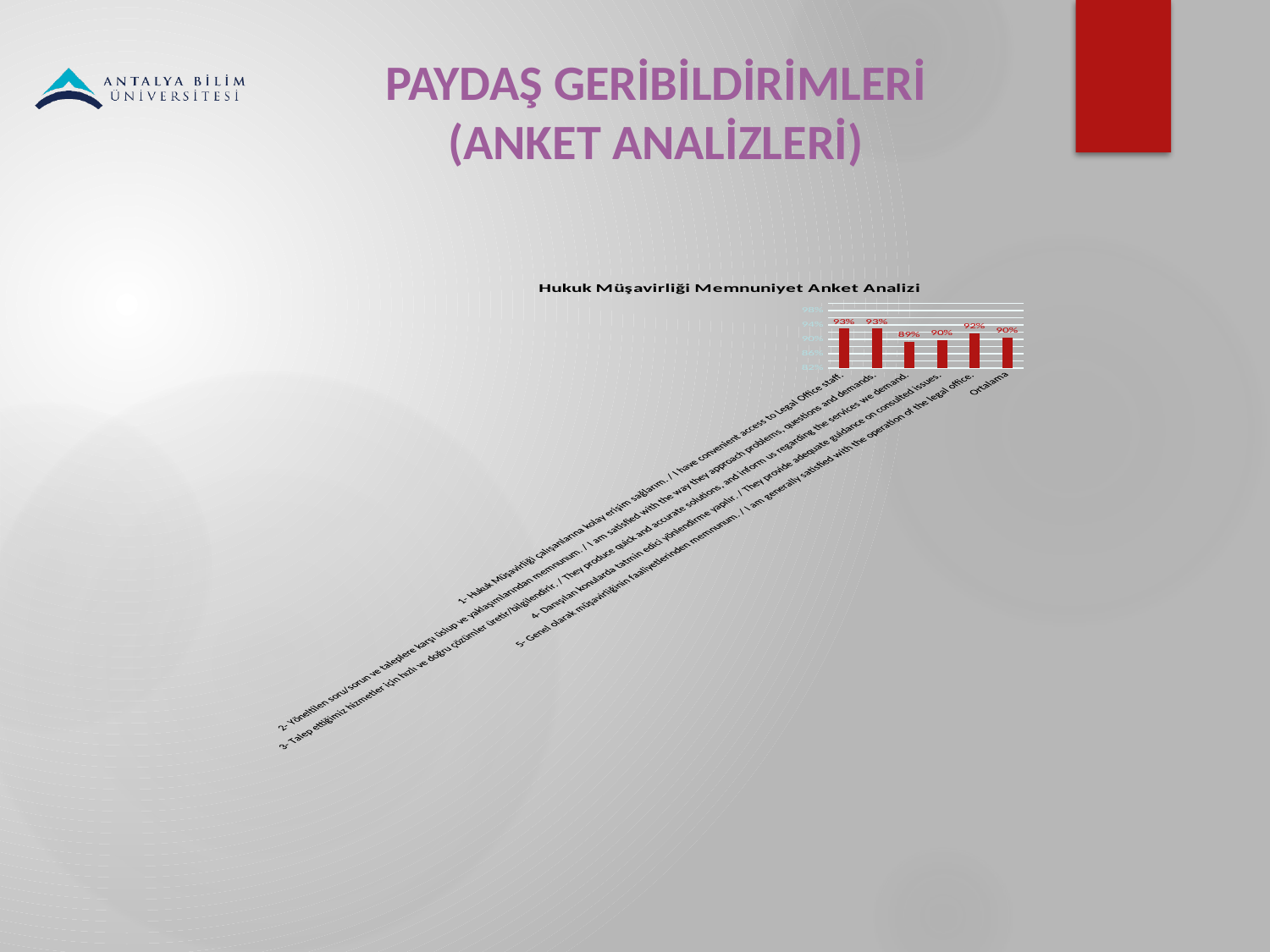
Which category has the lowest value in the Hukuk Müşavirliği Memnuniyet Anket Analizi chart? 3- Talep ettiğimiz hizmetler için hızlı ve doğru çözümler üretir/bilgilendirir. What kind of chart is shown on the slide? Bar chart Which has the larger value in the chart: item 4 or item 5? Item 5 What is the title of the chart on the slide? Hukuk Müşavirliği Memnuniyet Anket Analizi What is the value shown for item 3 ("3- Talep ettiğimiz hizmetler için hızlı ve doğru çözümler üretir/bilgilendirir.") in the chart? 89% What colour are the bars in the chart? Red What is the value shown for item 1 ("1- Hukuk Müşavirliği çalışanlarına kolay erişim sağlarım.") in the chart? 93% What is the difference between the value for item 1 and the value for "Ortalama" in the chart? 3% How many bars are shown in the Hukuk Müşavirliği Memnuniyet Anket Analizi chart? 6 What is the difference between the values for item 2 and item 3 in the chart? 4% What is the value shown for "Ortalama" in the Hukuk Müşavirliği Memnuniyet Anket Analizi chart? 90% What is the value shown for item 5 ("5- Genel olarak müşavirliğinin faaliyetlerinden memnunum.") in the chart? 92%